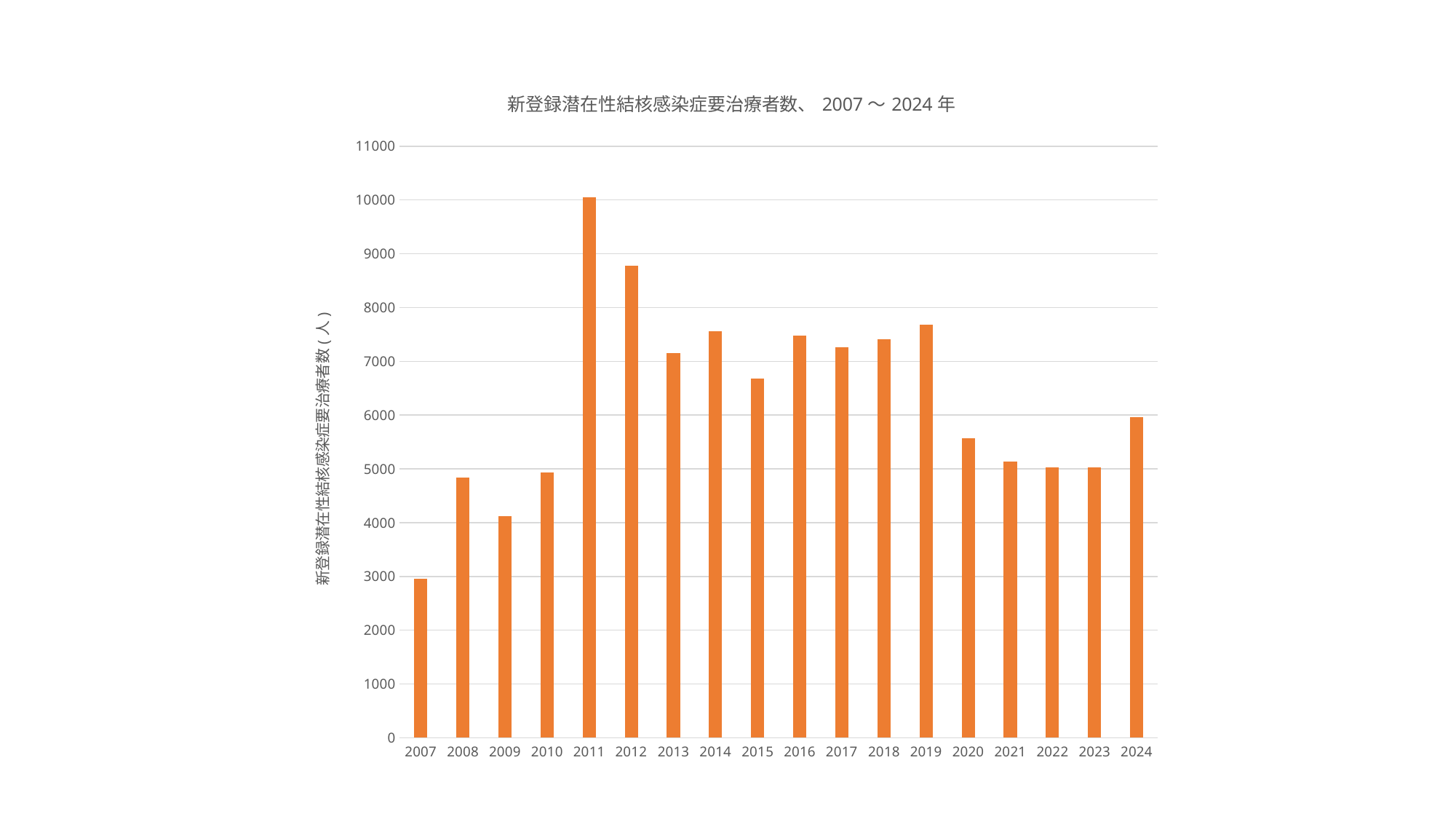
What is the title of the chart? 新登録潜在性結核感染症要治療者数、 2007 〜 2024 年 Is the value for 2012 greater or less than 9000? less Which is larger, the value for 2011 or the value for 2012? 2011 Is the value for 2015 greater or less than 6000? greater What kind of chart is shown on the slide? bar chart Which year has the highest value? 2011 Which is larger, the value for 2019 or the value for 2020? 2019 Which year has the lowest value? 2007 Is the value for 2020 greater or less than 5000? greater Do the values rise or fall from 2019 to 2022? fall How many years are plotted on the x axis? 18